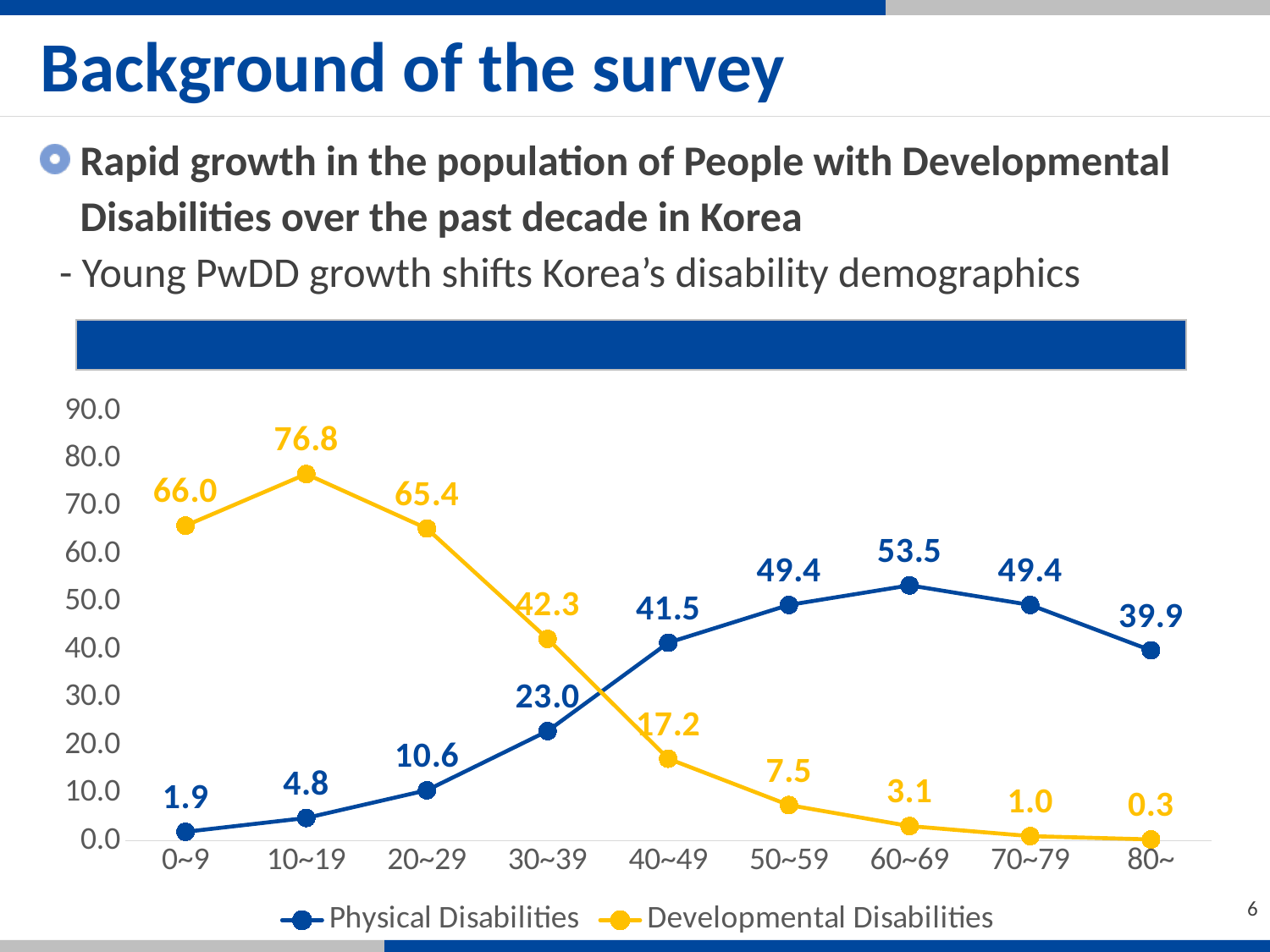
What is the difference between the Developmental Disabilities and Physical Disabilities values in the 0~9 age group? 64.1 Which age group has the highest value for Physical Disabilities? 60~69 What is the value for Developmental Disabilities in the 80~ age group? 0.3 Which age group has the lowest value for Developmental Disabilities? 80~ How many series does the legend list? 2 What is the value for Developmental Disabilities in the 10~19 age group? 76.8 What is the value for Physical Disabilities in the 60~69 age group? 53.5 How many age groups are shown on the x axis? 9 Which colour is used for the Developmental Disabilities series? Yellow In the 40~49 age group, which series has the larger value, Physical Disabilities or Developmental Disabilities? Physical Disabilities Does the Developmental Disabilities series rise or fall from the 20~29 age group to the 80~ age group? Fall What kind of chart is shown on the slide? Line chart